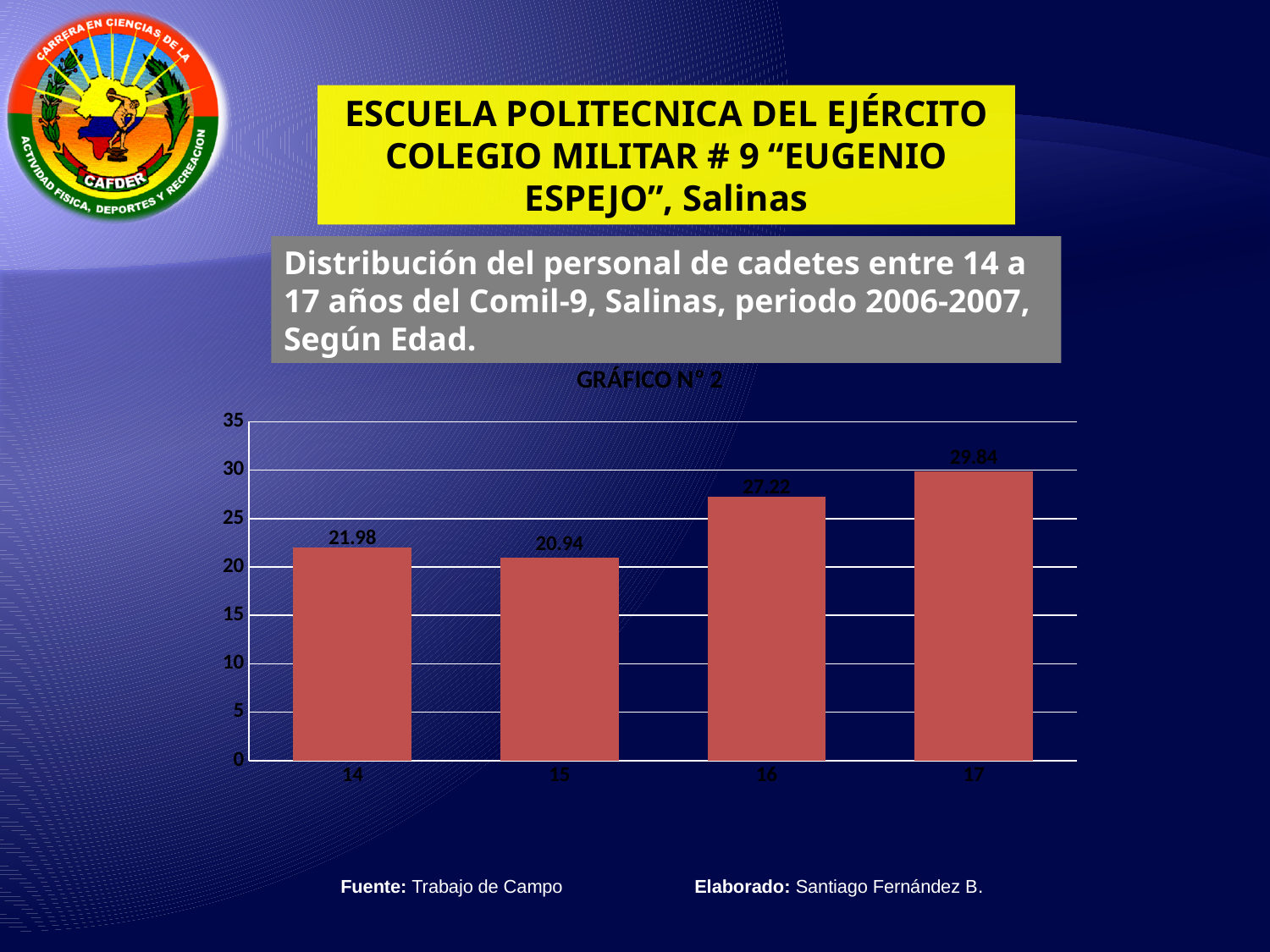
What is the value for age 15? 20.94 Which is larger, the value for age 16 or the value for age 15? 16 Which age category has the highest value? 17 What is the difference between the values for age 17 and age 14? 7.86 What is the value for age 17? 29.84 What is the value for age 16? 27.22 How many age categories are shown on the x axis? 4 Which age category has the lowest value? 15 Is the value for age 17 greater or less than 25? greater What kind of chart is shown on the slide? bar chart What is the value for age 14? 21.98 What is the title printed directly above the chart? GRÁFICO N° 2